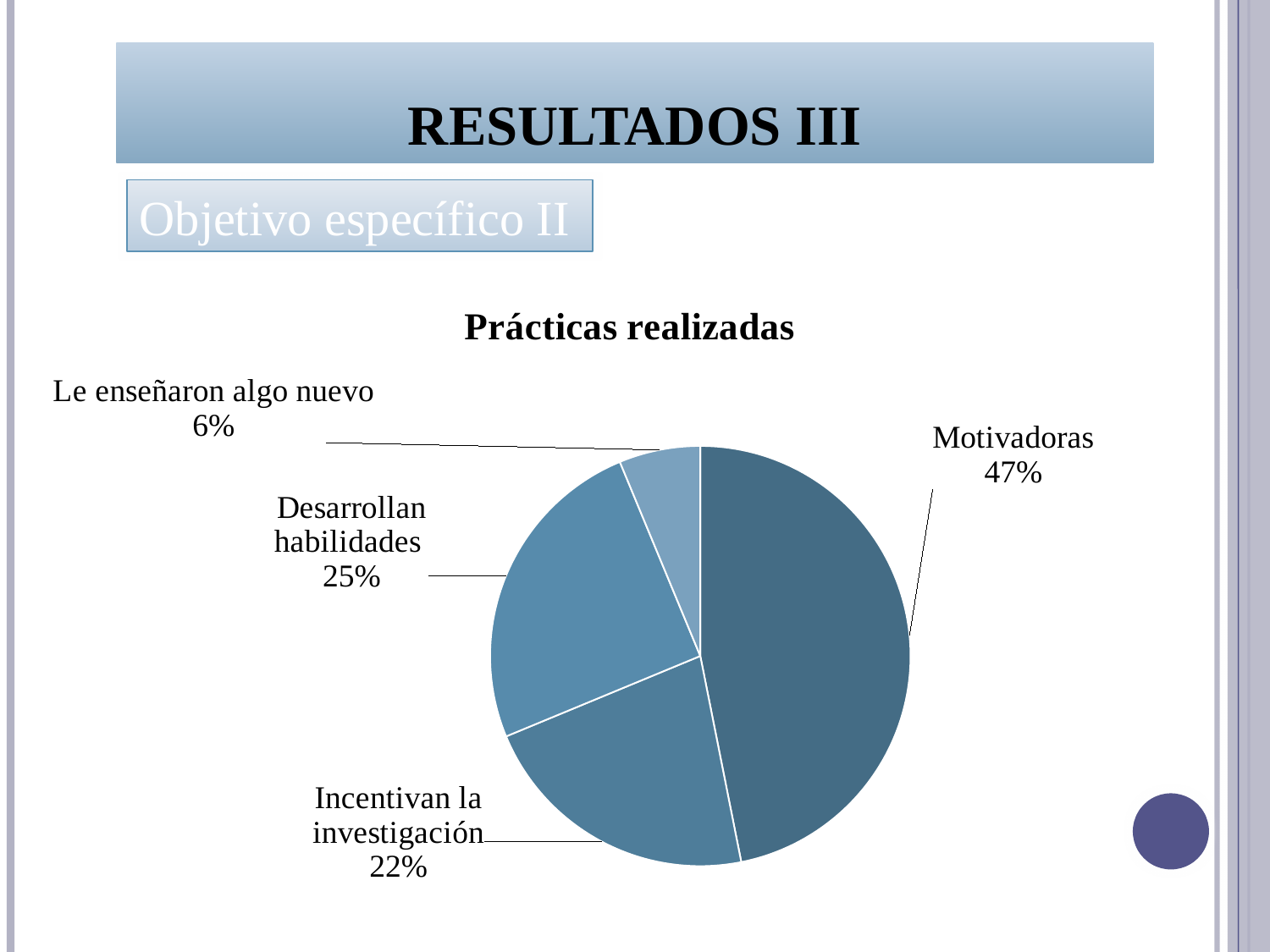
What is the title of the chart? Prácticas realizadas What is the difference in percentage points between Incentivan la investigación and Le enseñaron algo nuevo? 16 What percentage of the pie is labelled Desarrollan habilidades? 25% Which category has the smallest slice of the pie? Le enseñaron algo nuevo Which category has the largest slice of the pie? Motivadoras What is the difference in percentage points between Motivadoras and Desarrollan habilidades? 22 Which is larger, the slice for Desarrollan habilidades or the slice for Incentivan la investigación? Desarrollan habilidades What percentage of the pie is labelled Le enseñaron algo nuevo? 6% How many slices does the pie chart have? 4 What percentage of the pie is labelled Incentivan la investigación? 22% What type of chart is shown on the slide? pie chart What percentage of the pie is labelled Motivadoras? 47%